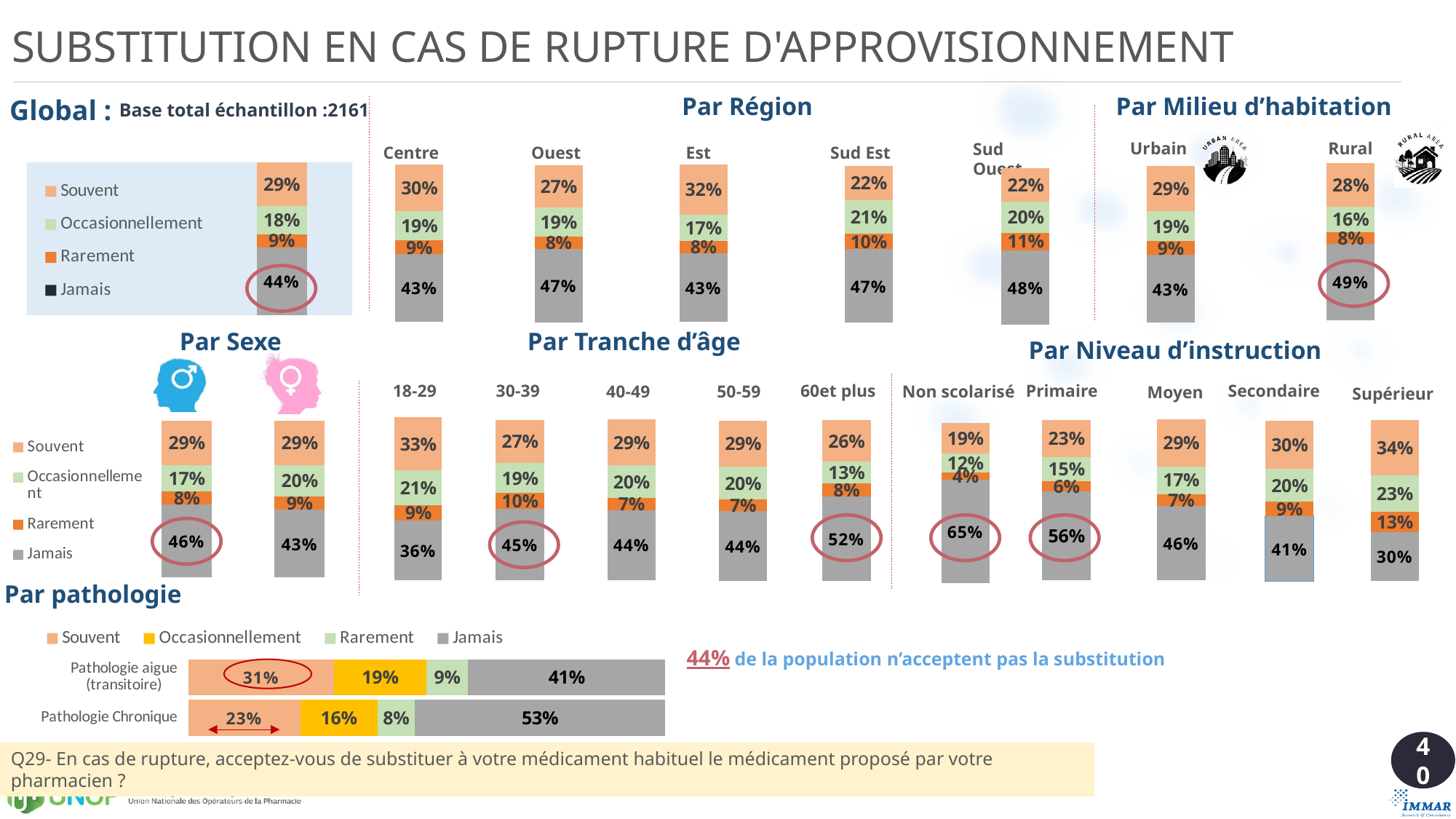
In the Par Milieu d'habitation chart, what is the difference between the Jamais values for Rural and Urbain? 6% How many categories does the Par Niveau d'instruction chart show? 5 How many series does the legend of the Par pathologie chart list? 4 In the Par Niveau d'instruction chart, which level has the lowest Jamais value? Supérieur In the Par Sexe chart, which has the larger Jamais value, men or women? Men In the Par Région chart, which region has the highest Souvent value? Est In the Par Tranche d'âge chart, which age group has the highest Jamais value? 60et plus In the Par Région chart, what is the Jamais value for Sud Ouest? 48% In the Par pathologie chart, what is the Jamais value for Pathologie Chronique? 53% In the Global chart, what is the value for Jamais? 44% In the Par Tranche d'âge chart, what is the Occasionnellement value for 18-29? 21% In the Par Niveau d'instruction chart, what is the Rarement value for Non scolarisé? 4%